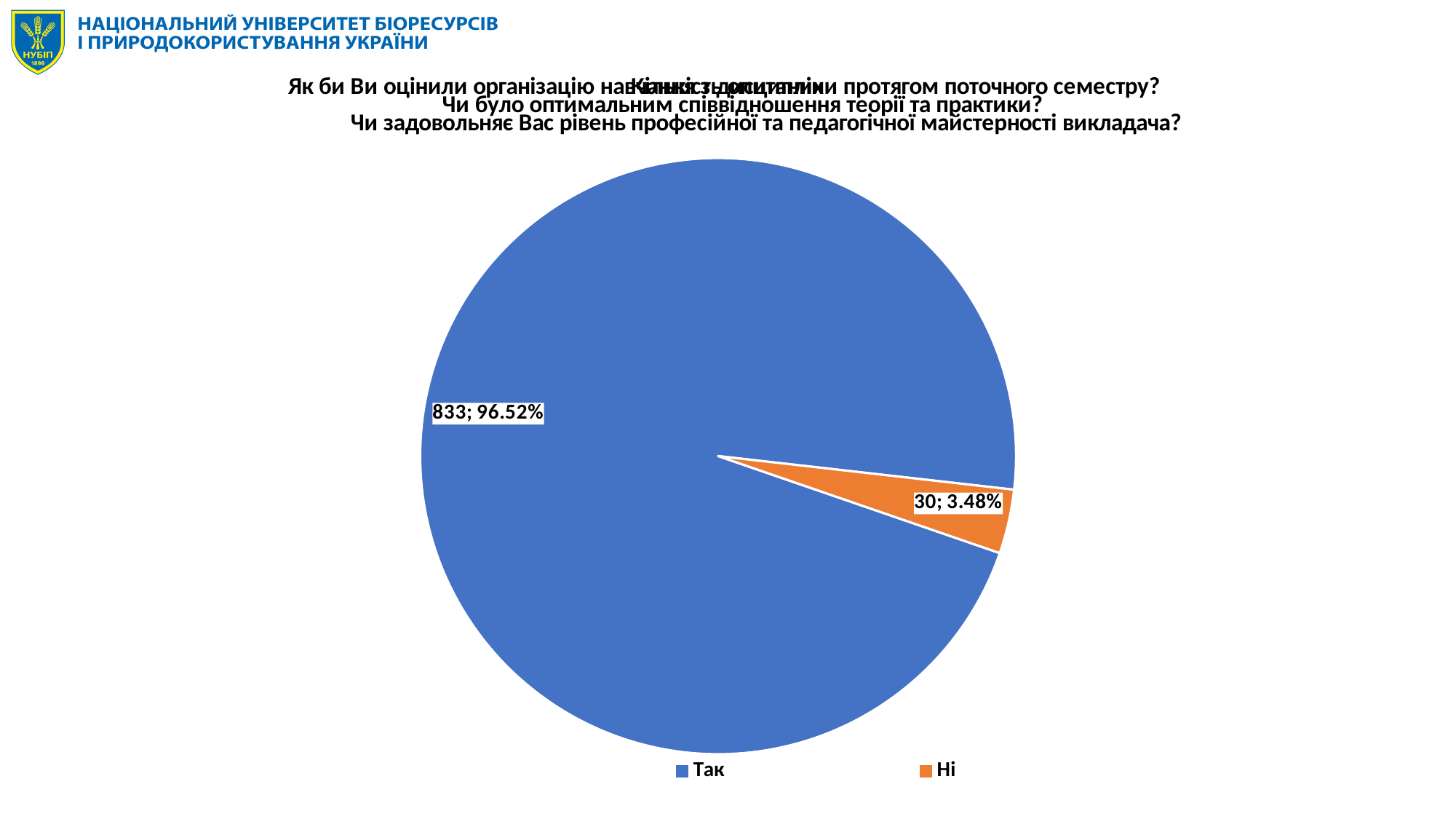
How many entries does the legend list? 2 What kind of chart is shown on the slide? pie chart Which is larger, the value for "Так" or the value for "Ні"? Так What is the difference between the values for "Так" and "Ні"? 803 What is the value shown for the "Ні" slice? 30 Which slice is the largest? Так What colour is the "Ні" slice? orange What is the value shown for the "Так" slice? 833 What share of the pie does the "Так" slice represent? 96.52% How many slices does the pie chart have? 2 What share of the pie does the "Ні" slice represent? 3.48% Which slice is the smallest? Ні